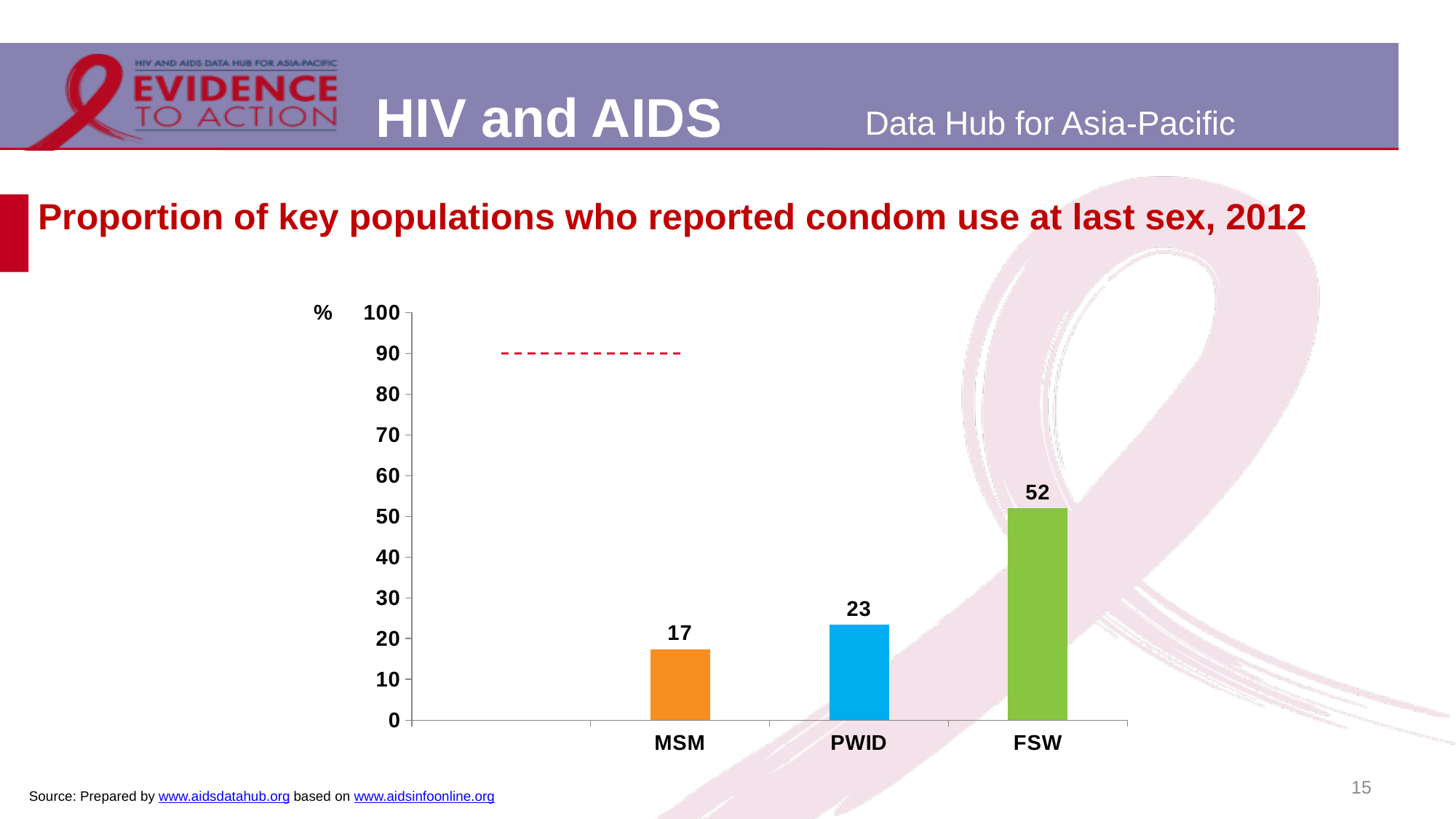
Which key population has the highest proportion reporting condom use at last sex? FSW Is the value for FSW greater or less than 50? greater Which is larger, the value for PWID or the value for MSM? PWID What is the title of the chart? Proportion of key populations who reported condom use at last sex, 2012 What is the value for FSW? 52 How many key populations are shown on the chart? 3 What is the difference between the values for PWID and MSM? 6 What is the value for PWID? 23 Which key population has the lowest proportion reporting condom use at last sex? MSM What is the difference between the values for FSW and MSM? 35 What kind of chart is shown on the slide? bar chart What is the value for MSM? 17